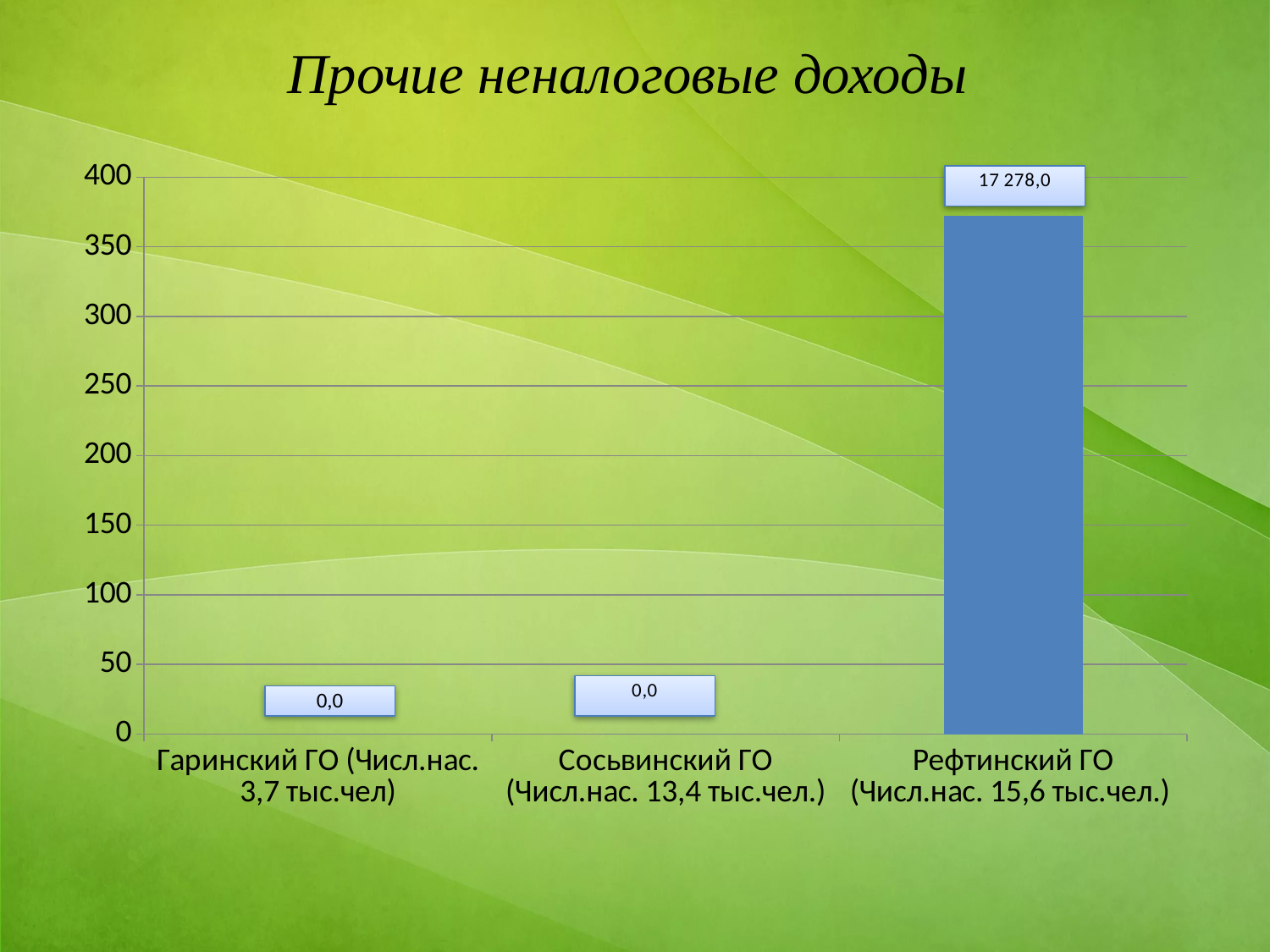
Is the value for Рефтинский ГО greater or less than 300? greater Which category has the highest value? Рефтинский ГО What is the difference between the values for Рефтинский ГО and Сосьвинский ГО? 17 278,0 What is the value for Сосьвинский ГО? 0,0 How many categories are shown on the x axis? 3 What is the value for Рефтинский ГО? 17 278,0 What colour is the bar for Рефтинский ГО? blue Which is larger, the value for Рефтинский ГО or the value for Гаринский ГО? Рефтинский ГО How many categories have a value of 0,0? 2 What kind of chart is shown on the slide? bar chart What is the value for Гаринский ГО? 0,0 What is the title of the chart? Прочие неналоговые доходы